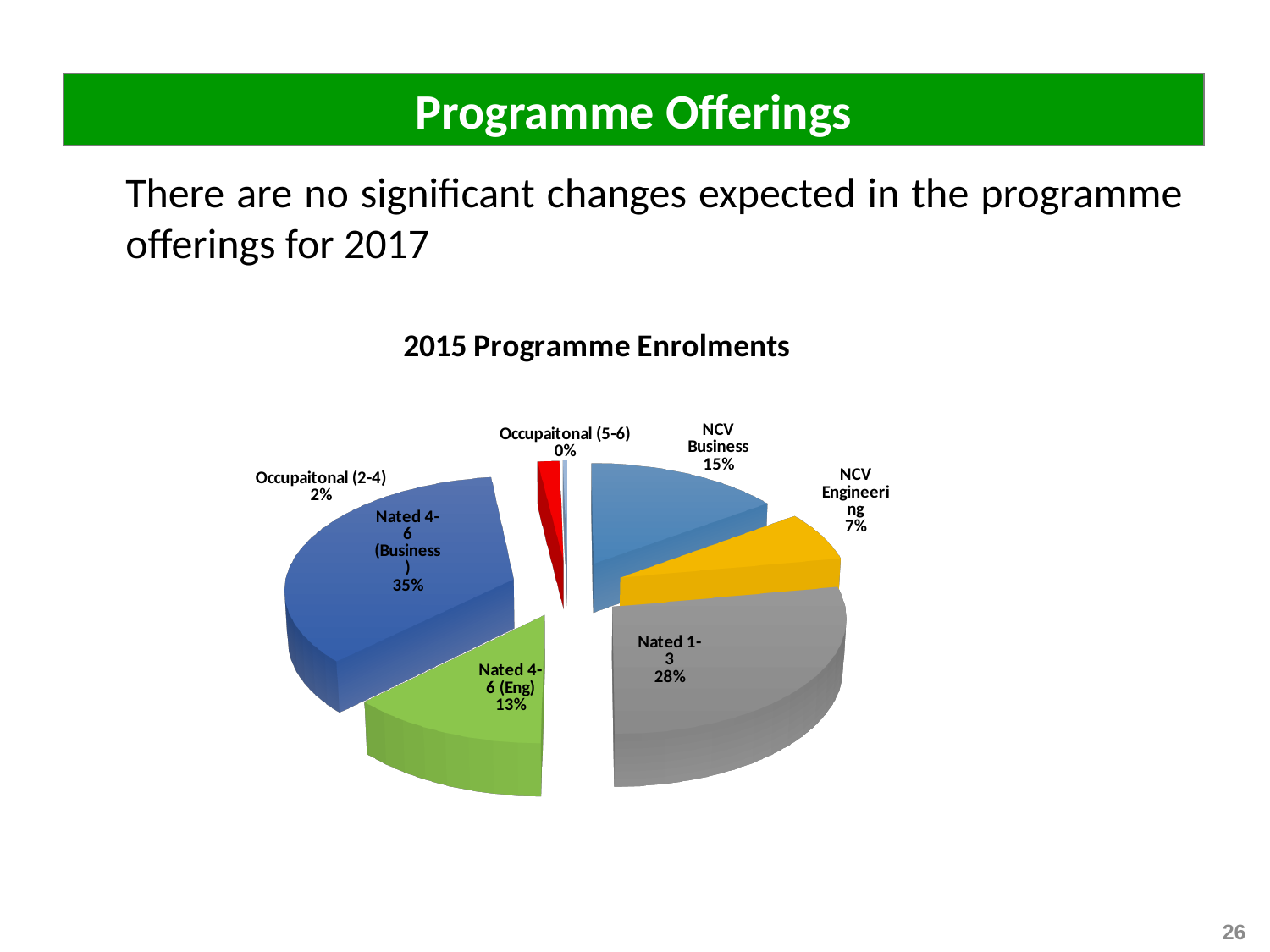
What share of 2015 programme enrolments is Nated 4-6 (Business)? 35% What share of 2015 programme enrolments is NCV Business? 15% What share of 2015 programme enrolments is Nated 1-3? 28% What is the difference in percentage points between Nated 4-6 (Business) and Nated 1-3? 7 What kind of chart is shown on the slide? Pie chart Which programme has the largest share of 2015 enrolments? Nated 4-6 (Business) What share of 2015 programme enrolments is NCV Engineering? 7% What is the title of the chart? 2015 Programme Enrolments Which programme has the smallest share of 2015 enrolments? Occupaitonal (5-6) What share of 2015 programme enrolments is Nated 4-6 (Eng)? 13% How many programme categories are shown in the pie chart? 7 Which has a larger share of 2015 enrolments, NCV Business or NCV Engineering? NCV Business